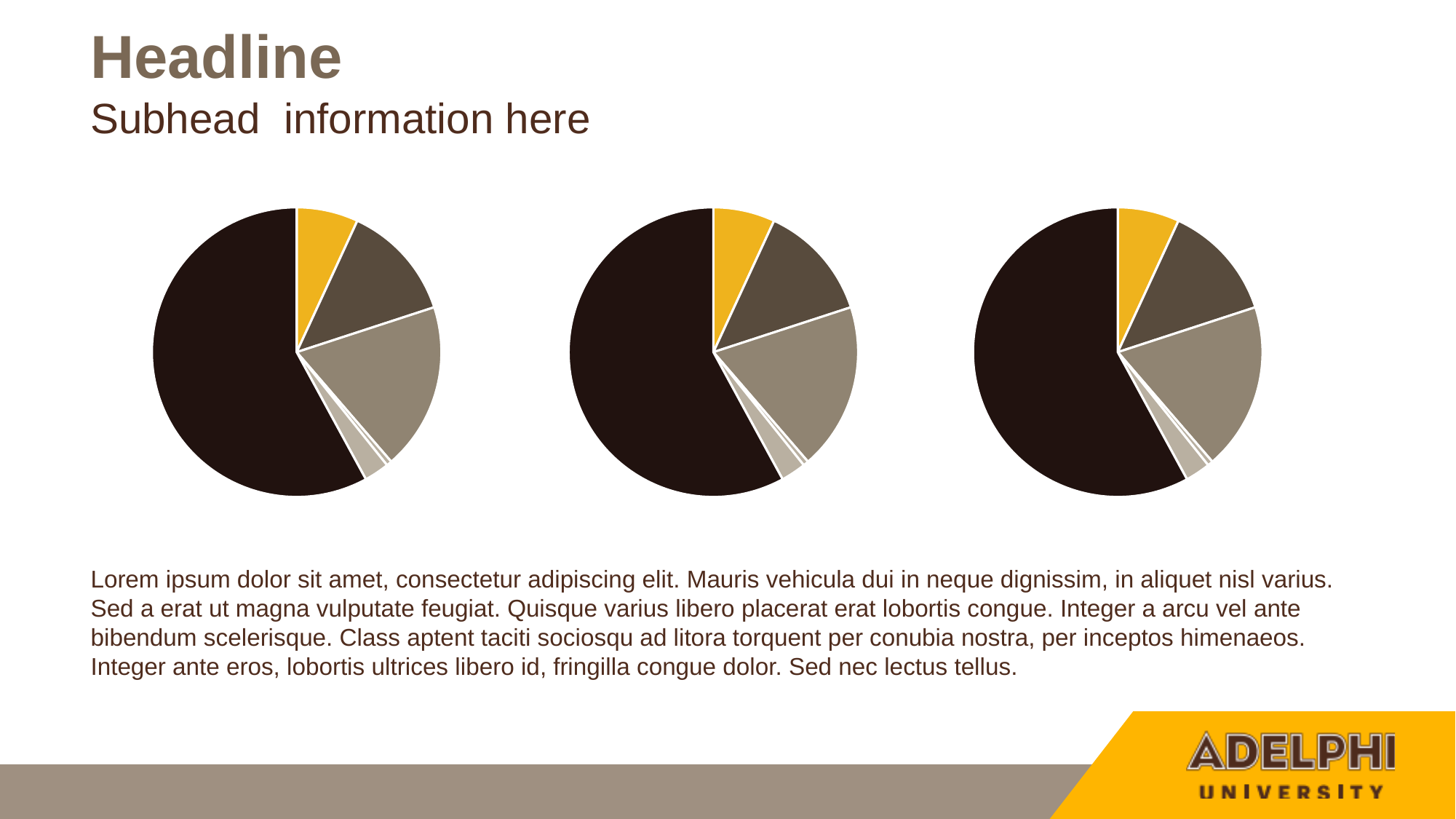
How many pie charts are shown on the slide? 3 In the left pie chart, is the dark brown slice more or less than half of the pie? more Do the pie charts on the slide have a legend? No In the middle pie chart, which colour slice is the largest? dark brown In the left pie chart, which colour slice is the largest? dark brown In the right pie chart, which colour slice is the largest? dark brown In the right pie chart, which is larger, the yellow slice or the dark brown slice? the dark brown slice What kind of chart is the leftmost chart on the slide? pie chart In the middle pie chart, which is larger, the yellow slice or the grey slice? the grey slice Are the three pie charts arranged in a row or in a column? in a row